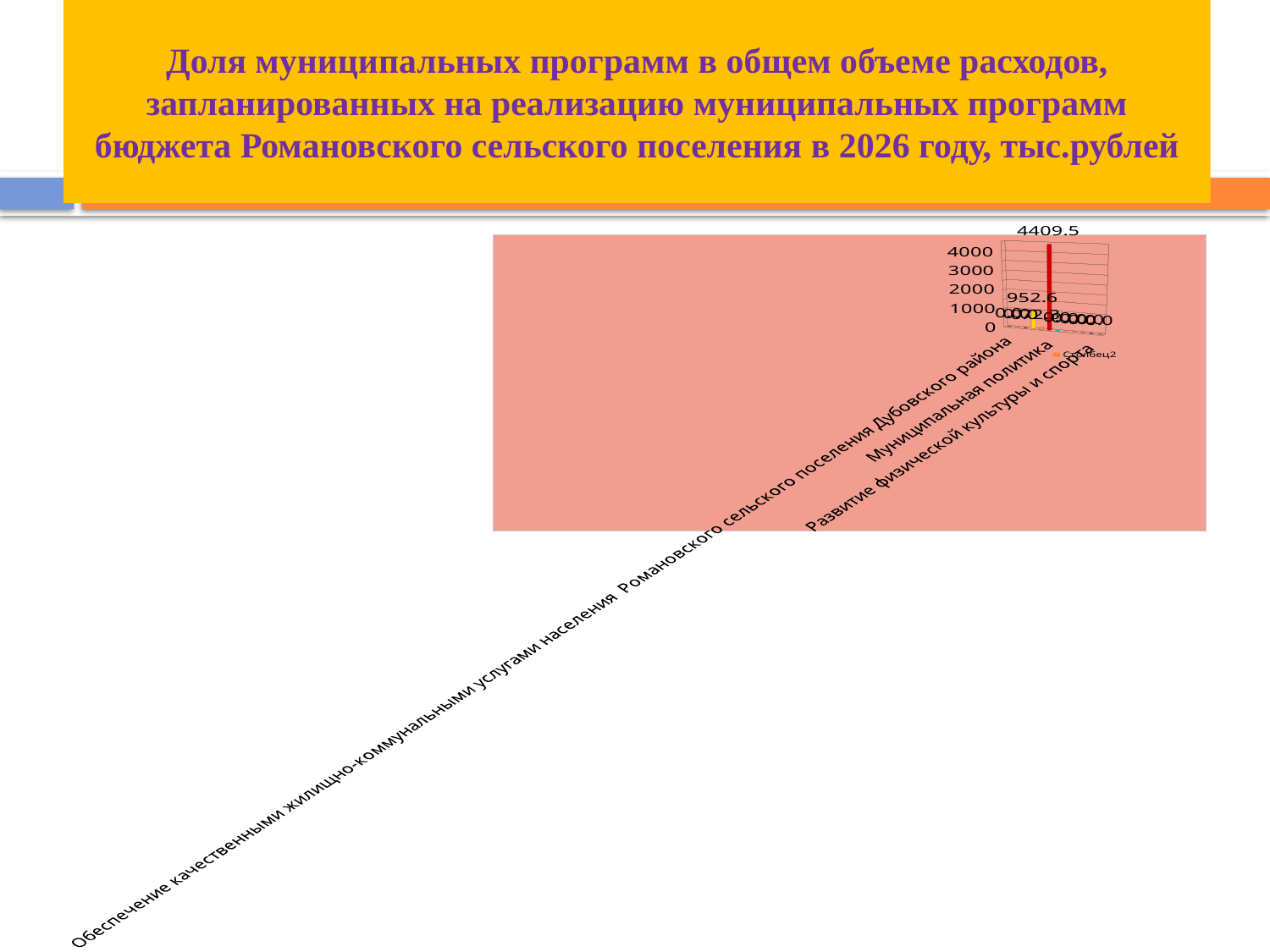
What kind of chart is shown on the slide? bar chart What colour is the tallest bar on the chart? red What is the highest tick value shown on the vertical axis? 4000 Is the value of the tallest bar greater or less than 4000? greater What is the value labelled on the yellow bar? 952.6 What is the legend entry shown on the chart? Столбец2 What is the difference between the two labelled values, 4409.5 and 952.6? 3456.9 What is the largest value labelled on the chart? 4409.5 How many series does the legend list? 1 Which is larger, the value on the red bar or the value on the yellow bar? the red bar (4409.5) Is the value of the yellow bar greater or less than 1000? less